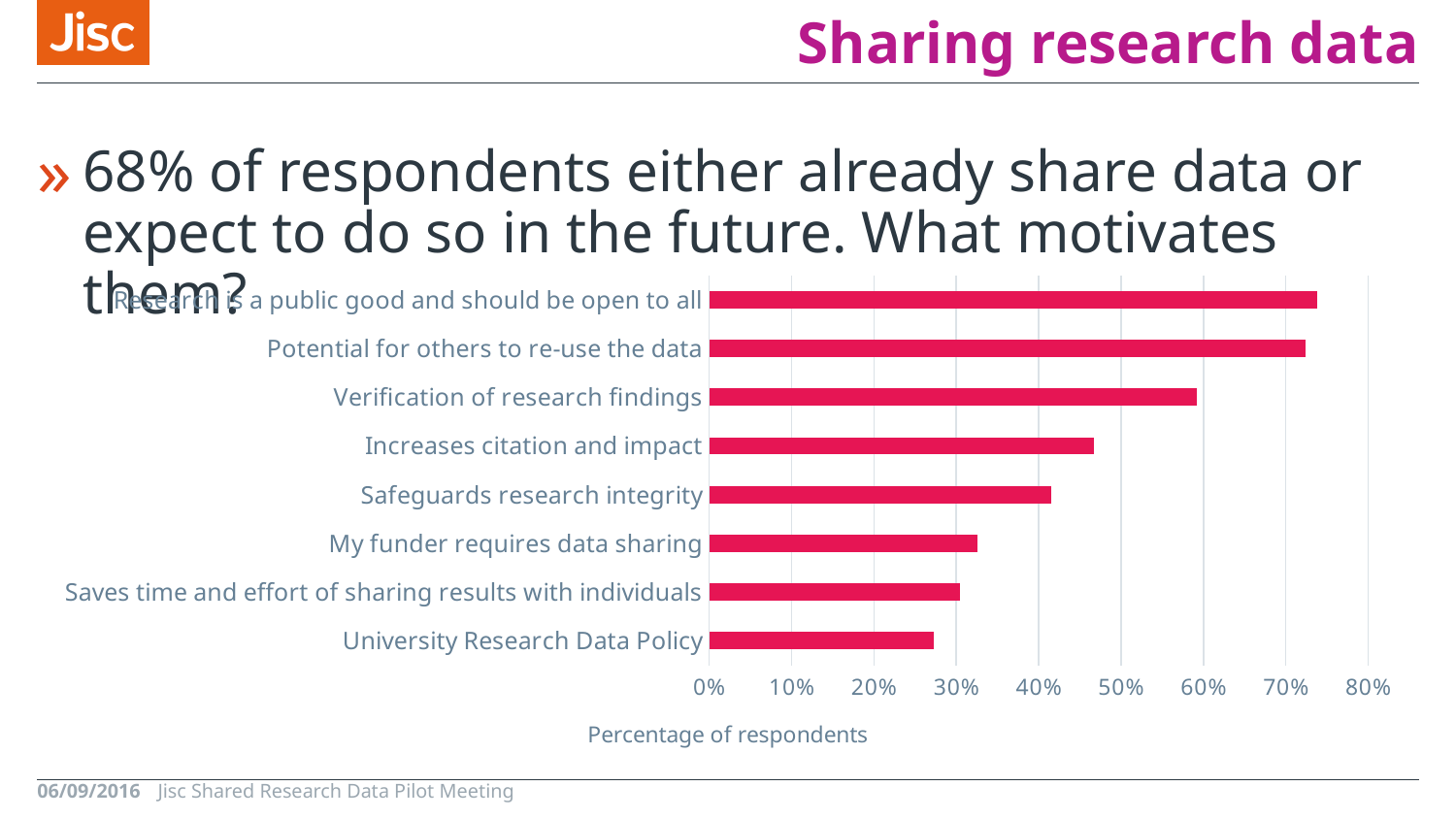
Is the value for 'Research is a public good and should be open to all' greater or less than 70%? greater Is the value for 'Saves time and effort of sharing results with individuals' greater or less than 40%? less Is the value for 'Safeguards research integrity' greater or less than 50%? less Which has the larger value: 'Safeguards research integrity' or 'University Research Data Policy'? Safeguards research integrity What kind of chart is shown on the slide? bar chart What is the title of the horizontal axis of the chart? Percentage of respondents Which has the larger value: 'Verification of research findings' or 'Increases citation and impact'? Verification of research findings How many categories (motivations) are plotted in the chart? 8